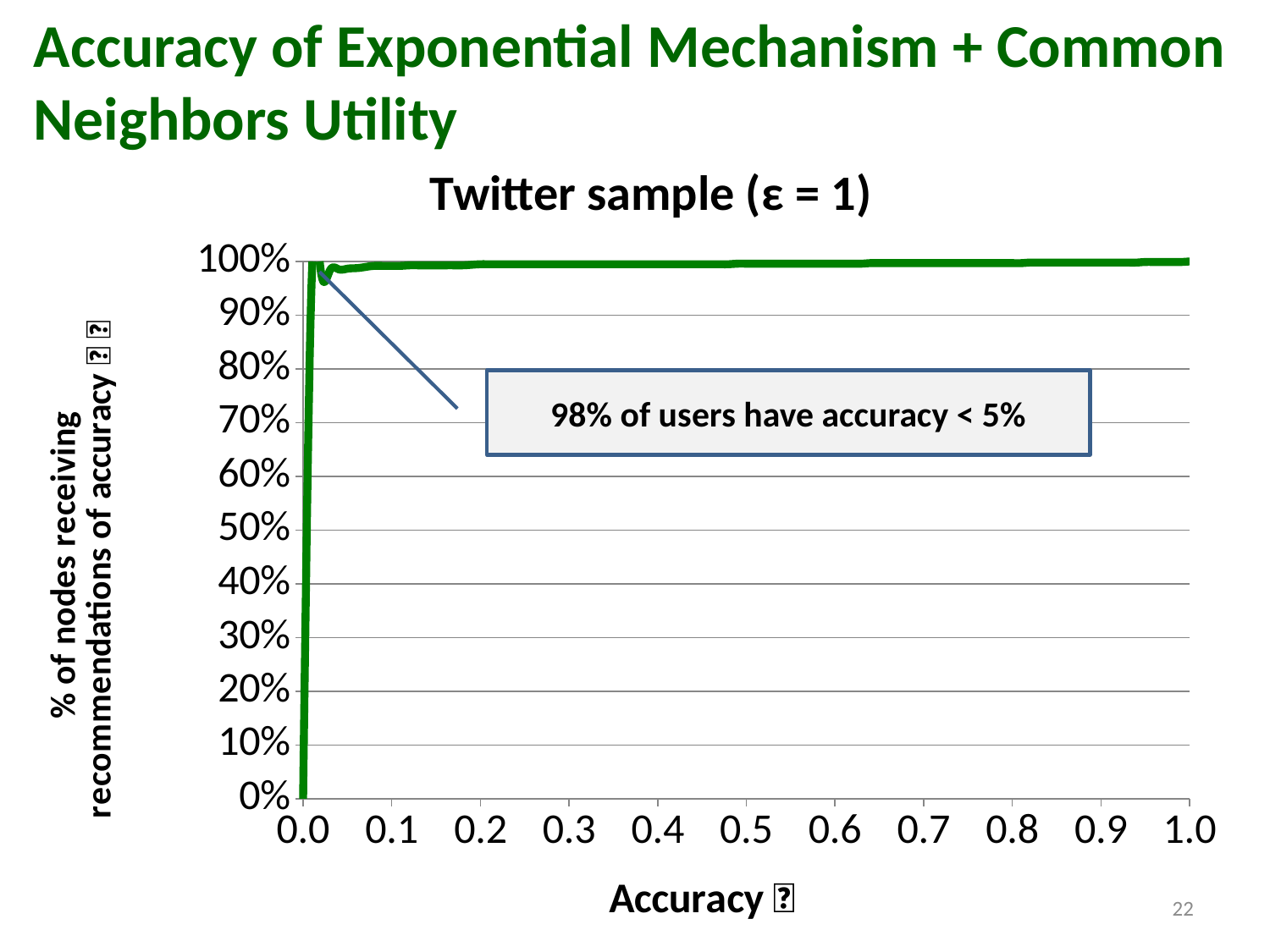
Is the value of the line at accuracy 0.5 greater or less than 90%? greater How many tick labels are shown on the x axis of the chart? 11 Does the line rise or fall as accuracy increases from 0.0 to 1.0? rise What is the largest value shown on the x axis of the chart? 1.0 What kind of chart is shown on the slide? line chart Is the value of the line at accuracy 1.0 greater or less than 90%? greater What is the highest value shown on the y axis of the chart? 100% Is the value of the line at accuracy 0.2 greater or less than 80%? greater What is the label of the x axis of the chart? Accuracy What is the title of the chart? Twitter sample (ε = 1) According to the annotation on the chart, what percentage of users have accuracy < 5%? 98%